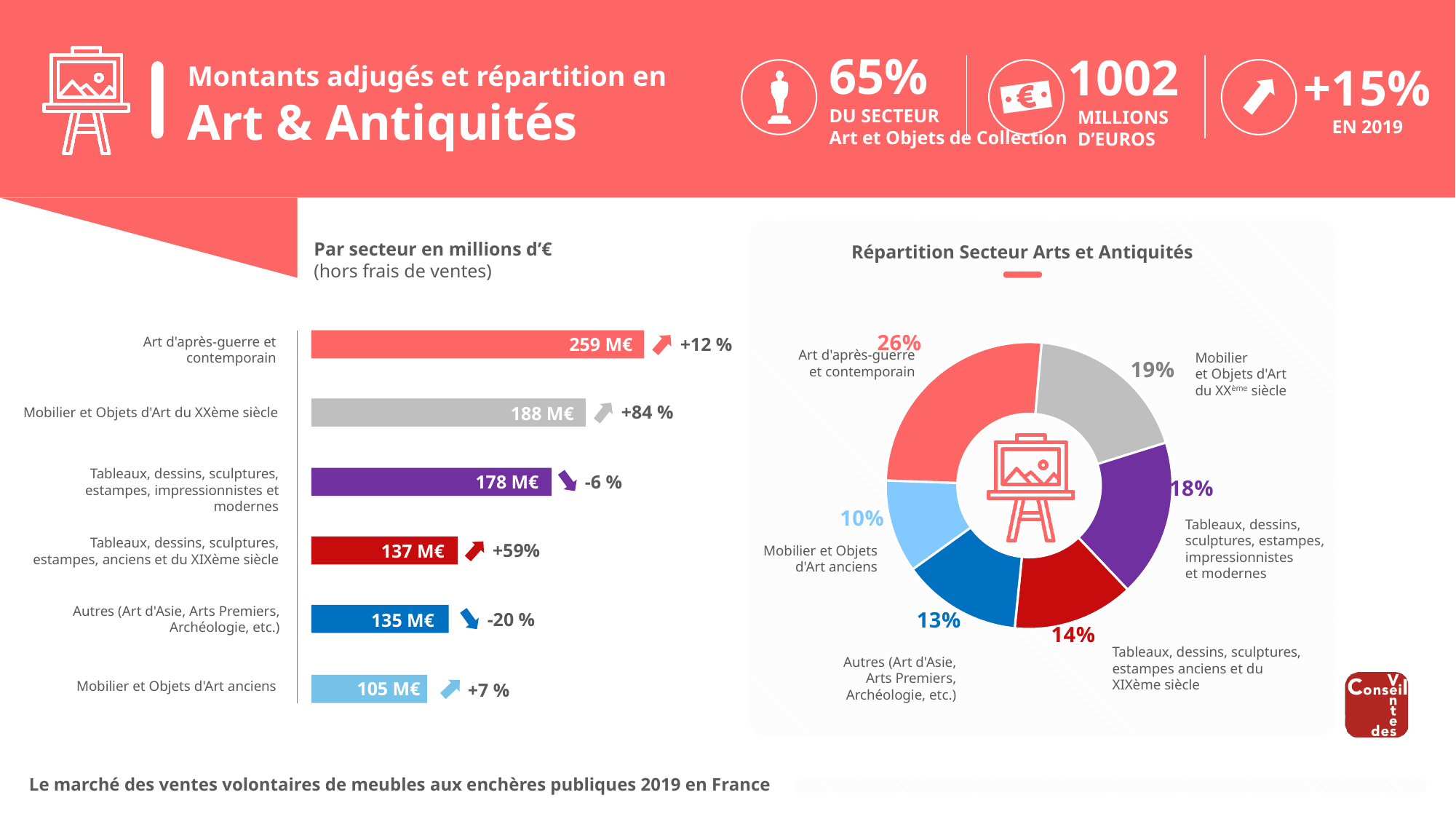
In the bar chart 'Par secteur en millions d'€', what is the value for 'Mobilier et Objets d'Art anciens'? 105 M€ In the donut chart 'Répartition Secteur Arts et Antiquités', which is larger: 'Mobilier et Objets d'Art du XXème siècle' or 'Tableaux, dessins, sculptures, estampes anciens et du XIXème siècle'? Mobilier et Objets d'Art du XXème siècle What kind of chart is 'Par secteur en millions d'€'? Bar chart In the donut chart 'Répartition Secteur Arts et Antiquités', what share does 'Autres (Art d'Asie, Arts Premiers, Archéologie, etc.)' have? 13% In the bar chart 'Par secteur en millions d'€', what is the value for 'Art d'après-guerre et contemporain'? 259 M€ In the bar chart 'Par secteur en millions d'€', what percentage change is shown next to 'Mobilier et Objets d'Art du XXème siècle'? +84 % In the bar chart 'Par secteur en millions d'€', which category has the lowest value? Mobilier et Objets d'Art anciens In the donut chart 'Répartition Secteur Arts et Antiquités', what share does 'Art d'après-guerre et contemporain' have? 26% In the bar chart 'Par secteur en millions d'€', which category has the highest value? Art d'après-guerre et contemporain In the bar chart 'Par secteur en millions d'€', what is the difference between 'Art d'après-guerre et contemporain' and 'Mobilier et Objets d'Art du XXème siècle'? 71 M€ What is the title of the chart on the right side of the slide? Répartition Secteur Arts et Antiquités In the bar chart 'Par secteur en millions d'€', how many categories are shown? 6